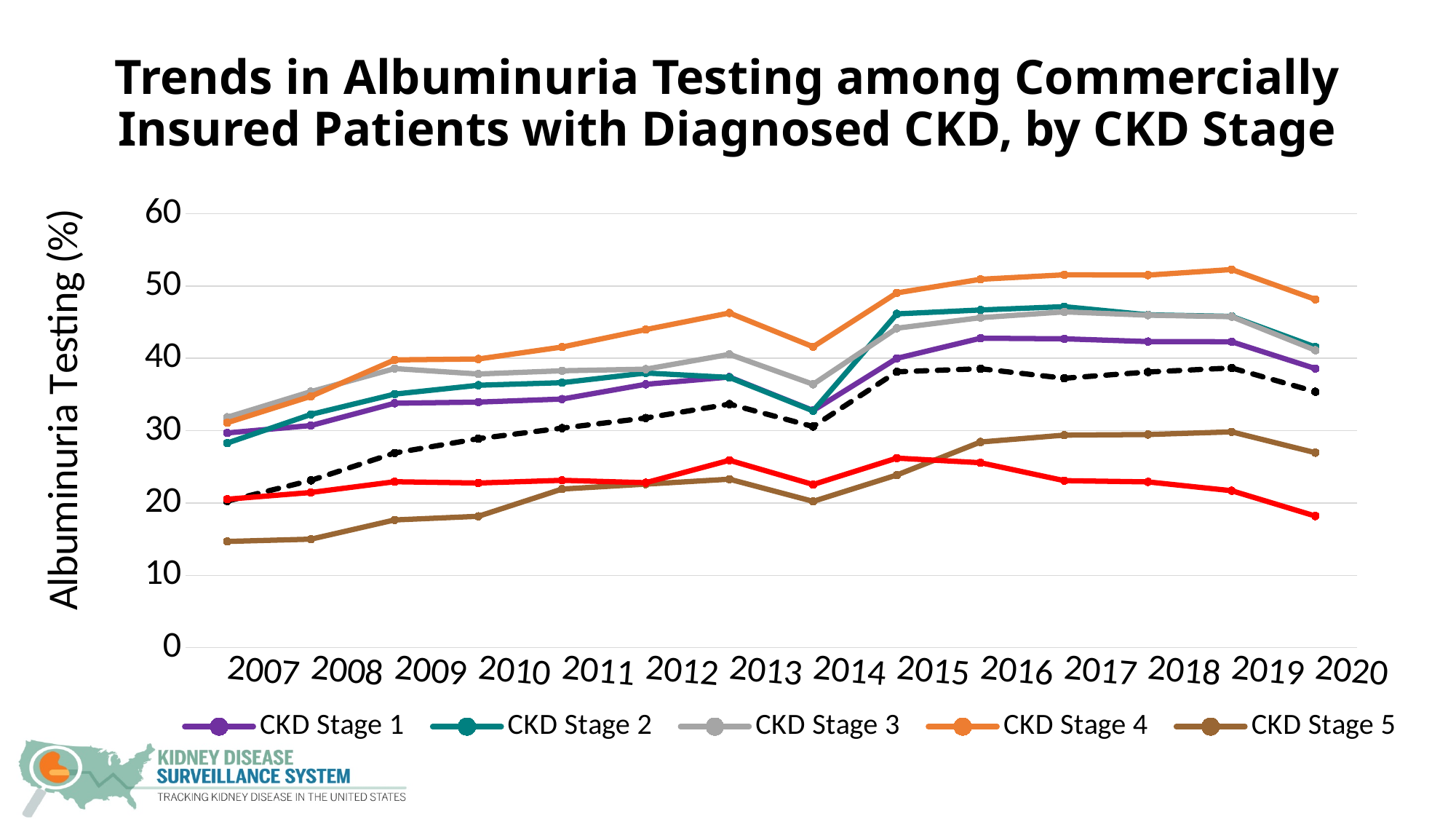
How many years are shown along the x axis? 14 In 2020, which is larger: CKD Stage 4 or CKD Stage 5? CKD Stage 4 Is the value for CKD Stage 4 in 2013 greater or less than 40? greater How many series does the legend list? 5 What kind of chart is shown on the slide? Line chart Does the CKD Stage 5 line rise or fall from 2007 to 2019? rise Which series has the lowest value in 2007? CKD Stage 5 Is the value for CKD Stage 4 in 2020 greater or less than 40? greater Is the value for CKD Stage 2 in 2014 greater or less than 40? less Which series has the highest value in 2020? CKD Stage 4 What is the label on the y axis? Albuminuria Testing (%)